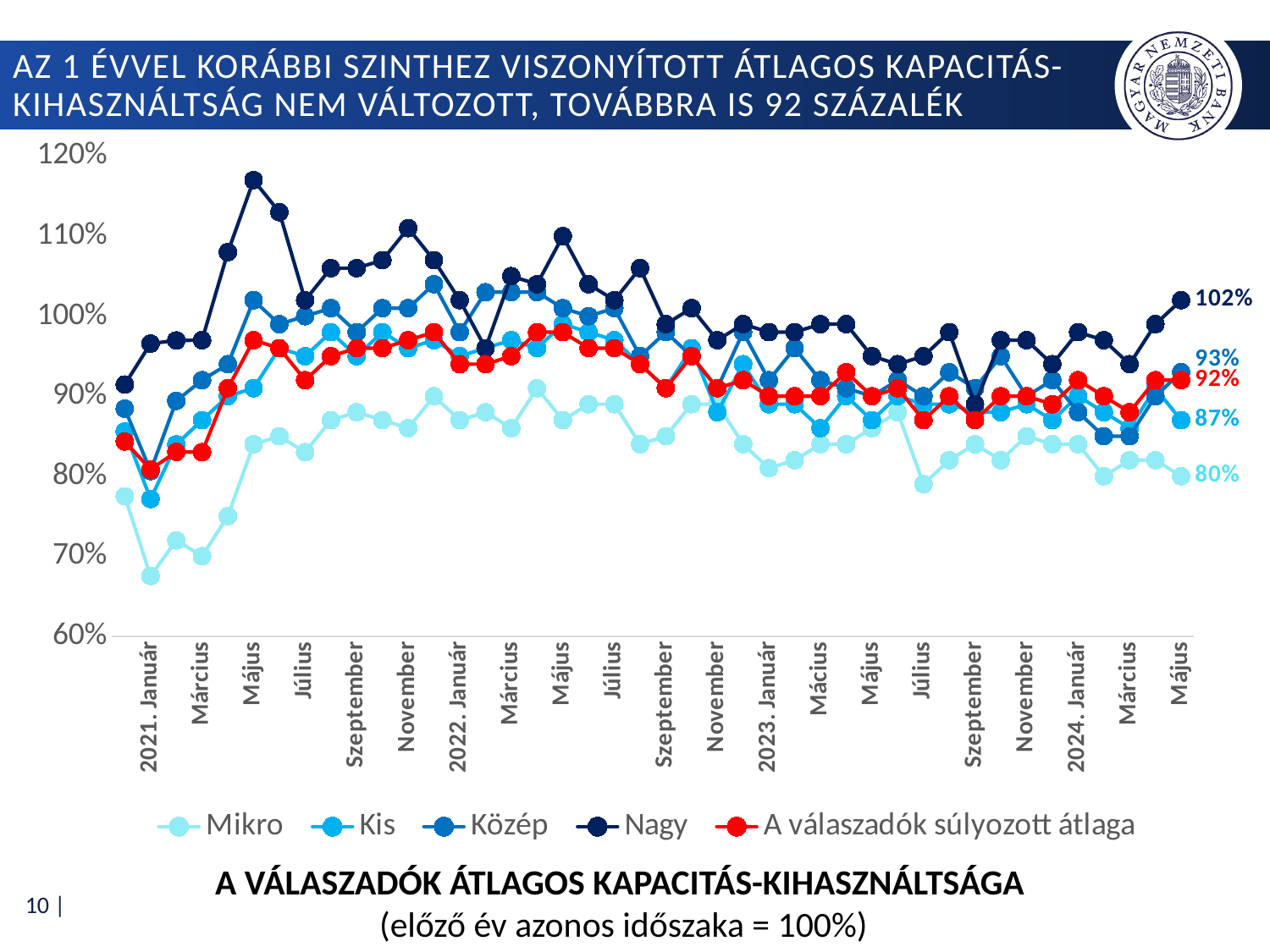
Which series has the lowest value at the last point (2024 Május)? Mikro What is the value of 'A válaszadók súlyozott átlaga' at the last point (2024 Május)? 92% What is the difference between the Nagy and Mikro values at the last point (2024 Május)? 22 percentage points How many series does the legend list? 5 What is the value for Nagy at the last point (2024 Május)? 102% What is the value for Közép at the last point (2024 Május)? 93% What kind of chart is shown on the slide? Line chart What is the value for Mikro at the last point (2024 Május)? 80% Which series has the highest value at the last point (2024 Május)? Nagy Is the value for Nagy in 2021 Május greater or less than 110%? greater At the last point (2024 Május), which is larger: Kis or Közép? Közép What is the value for Kis at the last point (2024 Május)? 87%